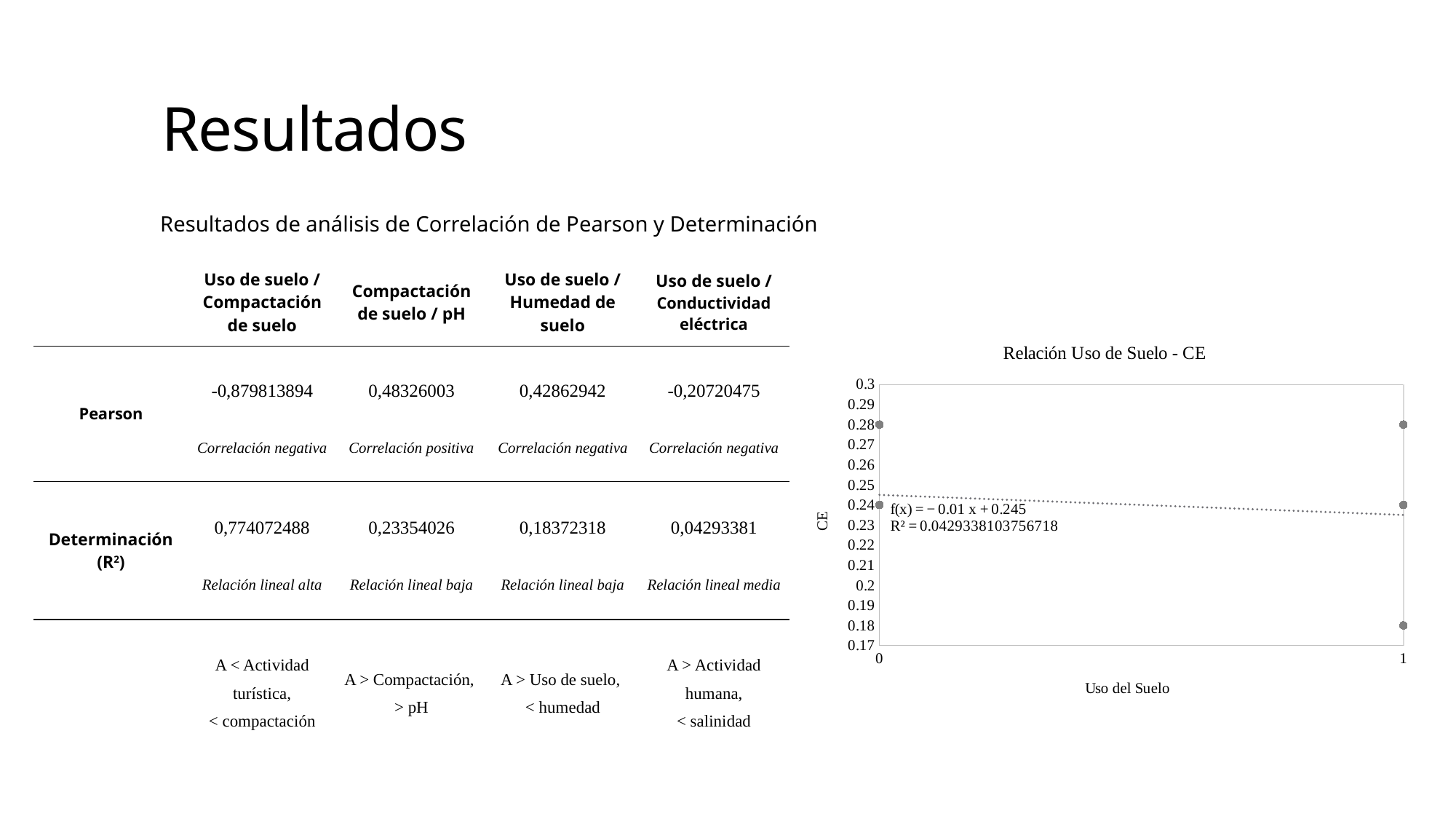
What is the label of the vertical axis of the chart? CE Is the lowest CE point at Uso del Suelo = 1 greater or less than 0.2? less At which Uso del Suelo value does the lowest CE point on the chart occur? 1 Is the highest CE point at Uso del Suelo = 0 greater or less than 0.27? greater Does the trendline on the chart rise or fall as Uso del Suelo increases from 0 to 1? fall What is the highest value shown on the CE axis of the chart? 0.3 What kind of chart is shown on the slide? scatter chart What is the intercept of the trendline equation shown on the chart? 0.245 What R² value is printed on the chart? R² = 0.0429338103756718 What is the equation of the trendline shown on the chart? f(x) = − 0.01 x + 0.245 Is the lowest CE point at Uso del Suelo = 0 greater or less than 0.22? greater What is the title of the chart on the slide? Relación Uso de Suelo - CE